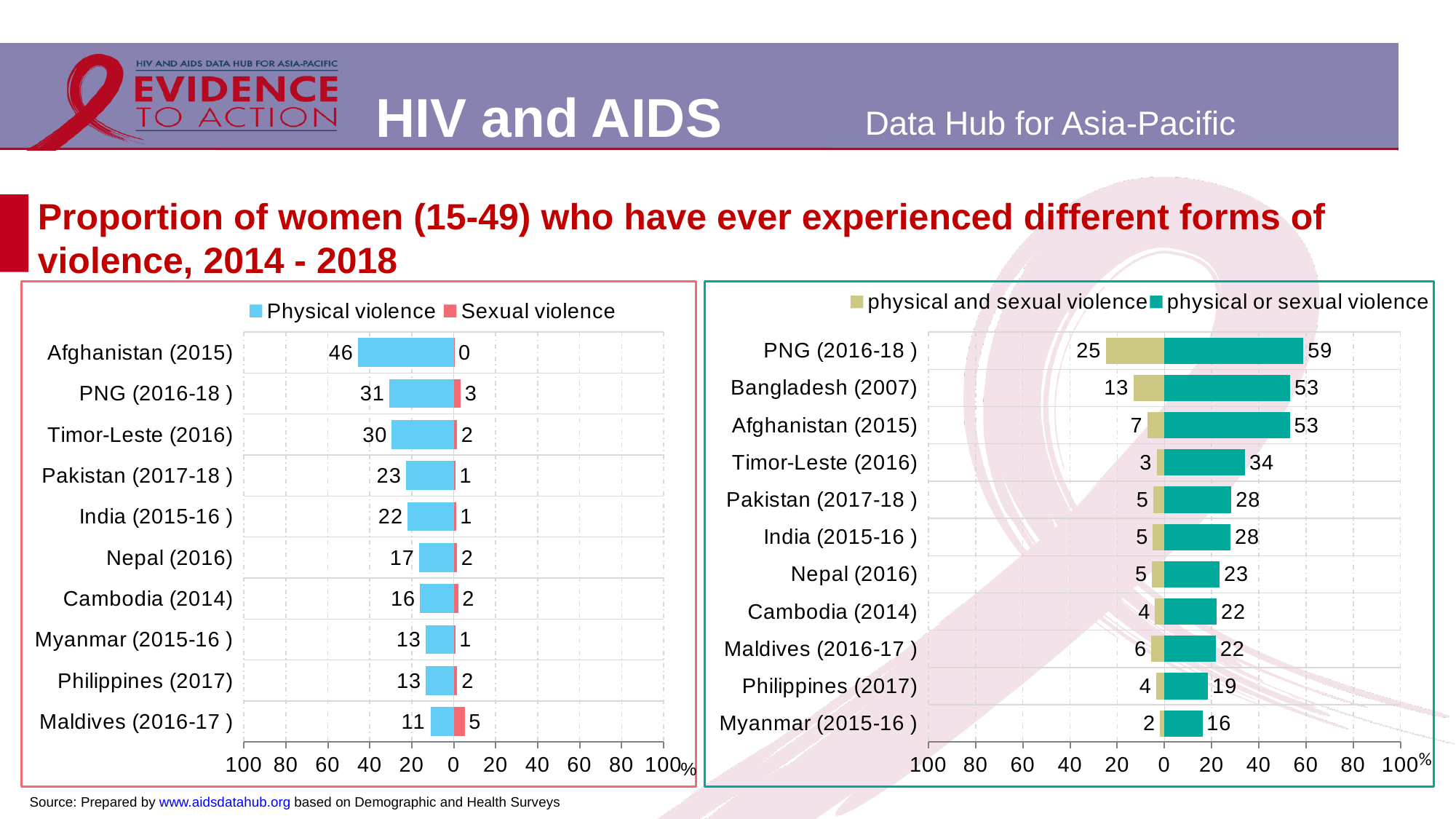
In the right chart, which country has the lowest physical or sexual violence value? Myanmar (2015-16) In the right chart, what is the physical or sexual violence value for PNG (2016-18)? 59 In the left chart, how many series does the legend list? 2 In the right chart, how many countries are shown? 11 In the right chart, which is larger: the physical or sexual violence value for Timor-Leste (2016) or for Nepal (2016)? Timor-Leste (2016) In the left chart, which country has the lowest Physical violence value? Maldives (2016-17) In the right chart, what is the physical and sexual violence value for Bangladesh (2007)? 13 In the left chart, what is the Physical violence value for Afghanistan (2015)? 46 What type of chart is the left chart? Bar chart In the left chart, what is the Sexual violence value for Maldives (2016-17)? 5 In the left chart, which country has the highest Physical violence value? Afghanistan (2015) In the left chart, what is the difference between the Physical violence values for PNG (2016-18) and Timor-Leste (2016)? 1